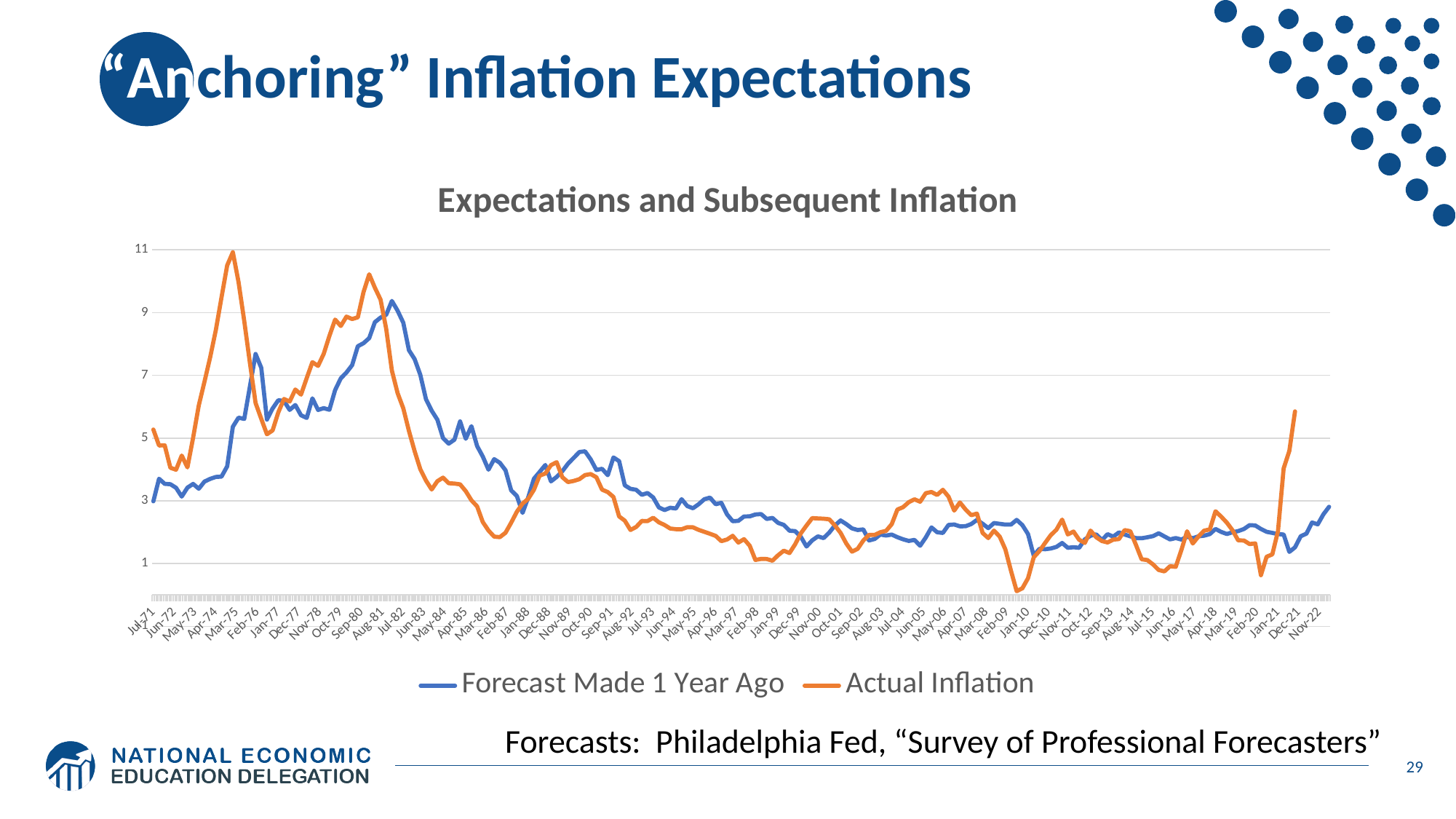
Is the value of Actual Inflation around Jan-10 greater or less than 1? less Does Actual Inflation rise or fall between Aug-81 and Jun-83? Fall What kind of chart is shown on the slide? Line chart Which series reaches the lowest value anywhere on the chart? Actual Inflation Around Jul-82, which series has the higher value, Forecast Made 1 Year Ago or Actual Inflation? Forecast Made 1 Year Ago Which colour is used for the Actual Inflation line? Orange Is the peak value of Actual Inflation around Mar-75 greater or less than 9? greater How many series does the legend list? 2 Which series reaches the highest value anywhere on the chart? Actual Inflation What is the title of the chart? Expectations and Subsequent Inflation